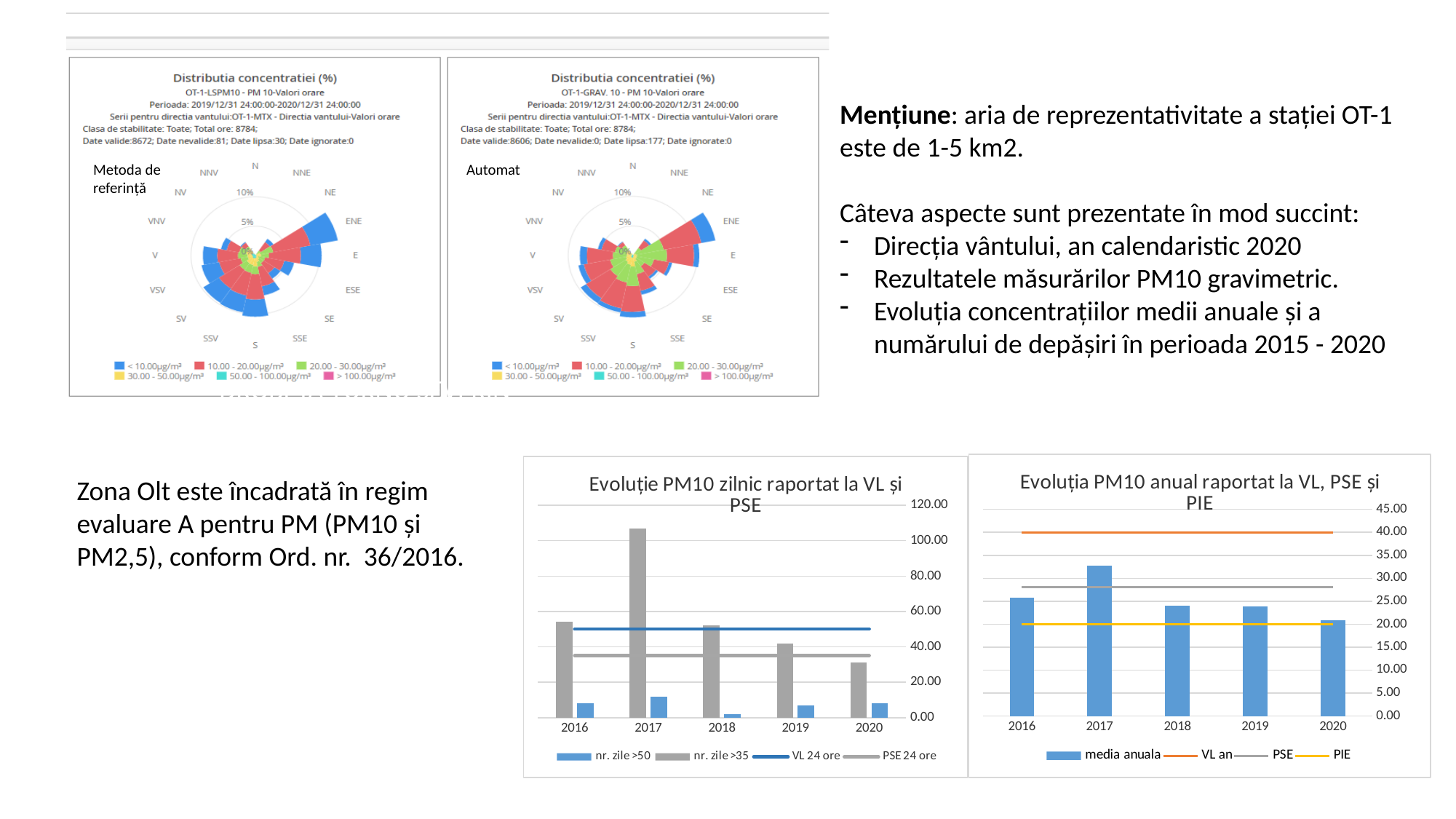
In the chart 'Evoluția PM10 anual raportat la VL, PSE și PIE', what colour is the 'VL an' line? orange In the chart 'Evoluția PM10 anual raportat la VL, PSE și PIE', does the 'media anuala' rise or fall from 2017 to 2020? fall In the chart 'Evoluție PM10 zilnic raportat la VL și PSE', is the value for 'nr. zile >35' in 2020 greater or less than 40.00? less How many years are shown on the x axis of the chart 'Evoluție PM10 zilnic raportat la VL și PSE'? 5 In the chart 'Evoluția PM10 anual raportat la VL, PSE și PIE', is the 'media anuala' for 2017 greater or less than 30.00? greater In the chart 'Evoluție PM10 zilnic raportat la VL și PSE', which year has the lowest value for 'nr. zile >35'? 2020 In the chart 'Evoluție PM10 zilnic raportat la VL și PSE', what kind of chart is used for the 'nr. zile >35' series? bar chart In the chart 'Evoluția PM10 anual raportat la VL, PSE și PIE', which year has the highest 'media anuala'? 2017 How many series does the legend of the chart 'Evoluție PM10 zilnic raportat la VL și PSE' list? 4 In the chart 'Evoluție PM10 zilnic raportat la VL și PSE', which is larger: 'nr. zile >35' in 2016 or in 2019? 2016 In the chart 'Evoluție PM10 zilnic raportat la VL și PSE', which year has the highest value for 'nr. zile >35'? 2017 In the chart 'Evoluție PM10 zilnic raportat la VL și PSE', is the value for 'nr. zile >35' in 2017 greater or less than 100.00? greater